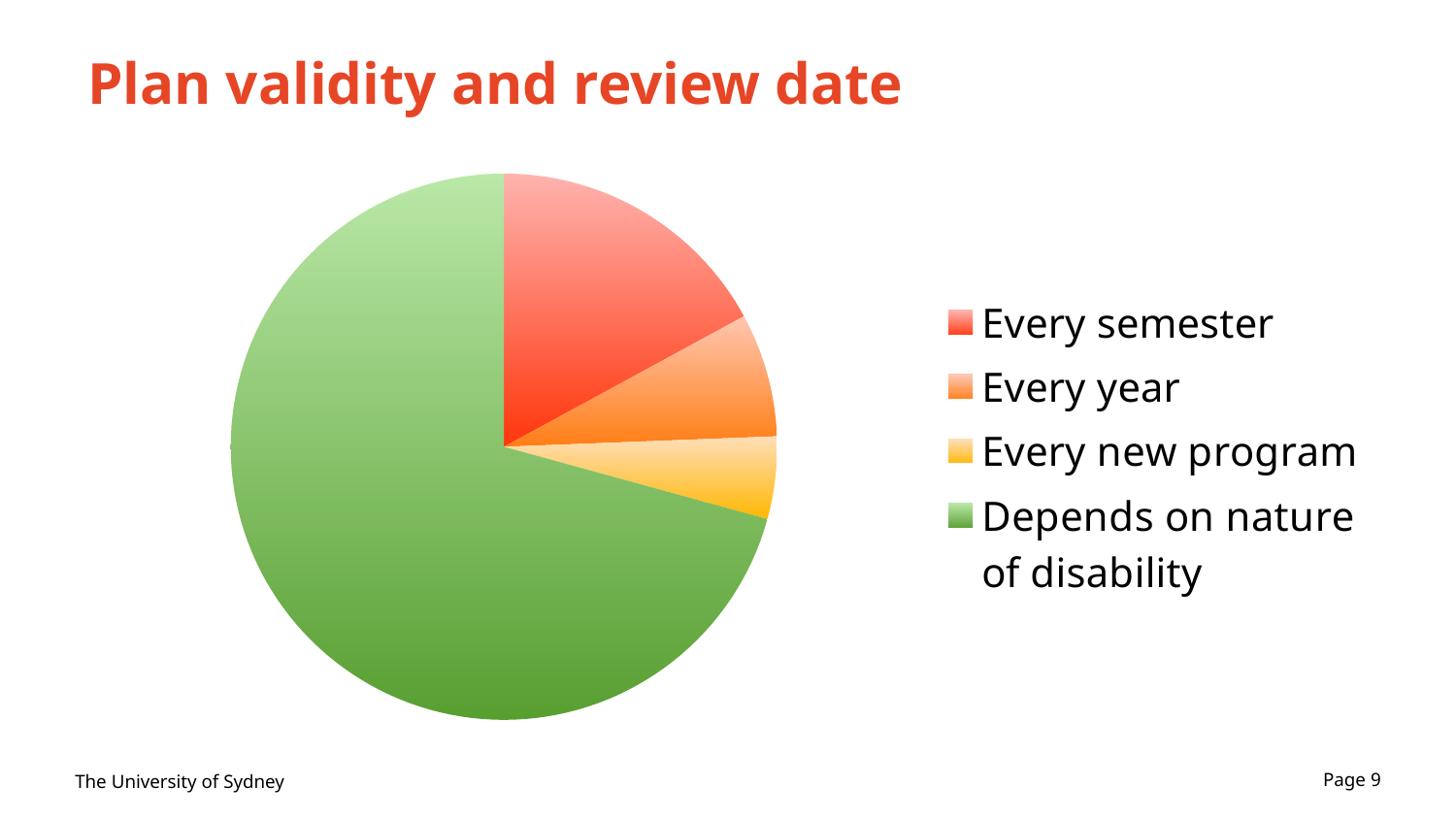
What is the title of the slide containing the pie chart? Plan validity and review date Which category has the smallest slice of the pie? Every new program What kind of chart is shown on the slide? Pie chart Which slice is larger, Every year or Every new program? Every year What colour is the slice for Depends on nature of disability? Green Which slice is larger, Every semester or Depends on nature of disability? Depends on nature of disability How many slices does the pie chart have? 4 Which slice is larger, Every new program or Depends on nature of disability? Depends on nature of disability How many entries does the legend list? 4 Which category has the largest slice of the pie? Depends on nature of disability